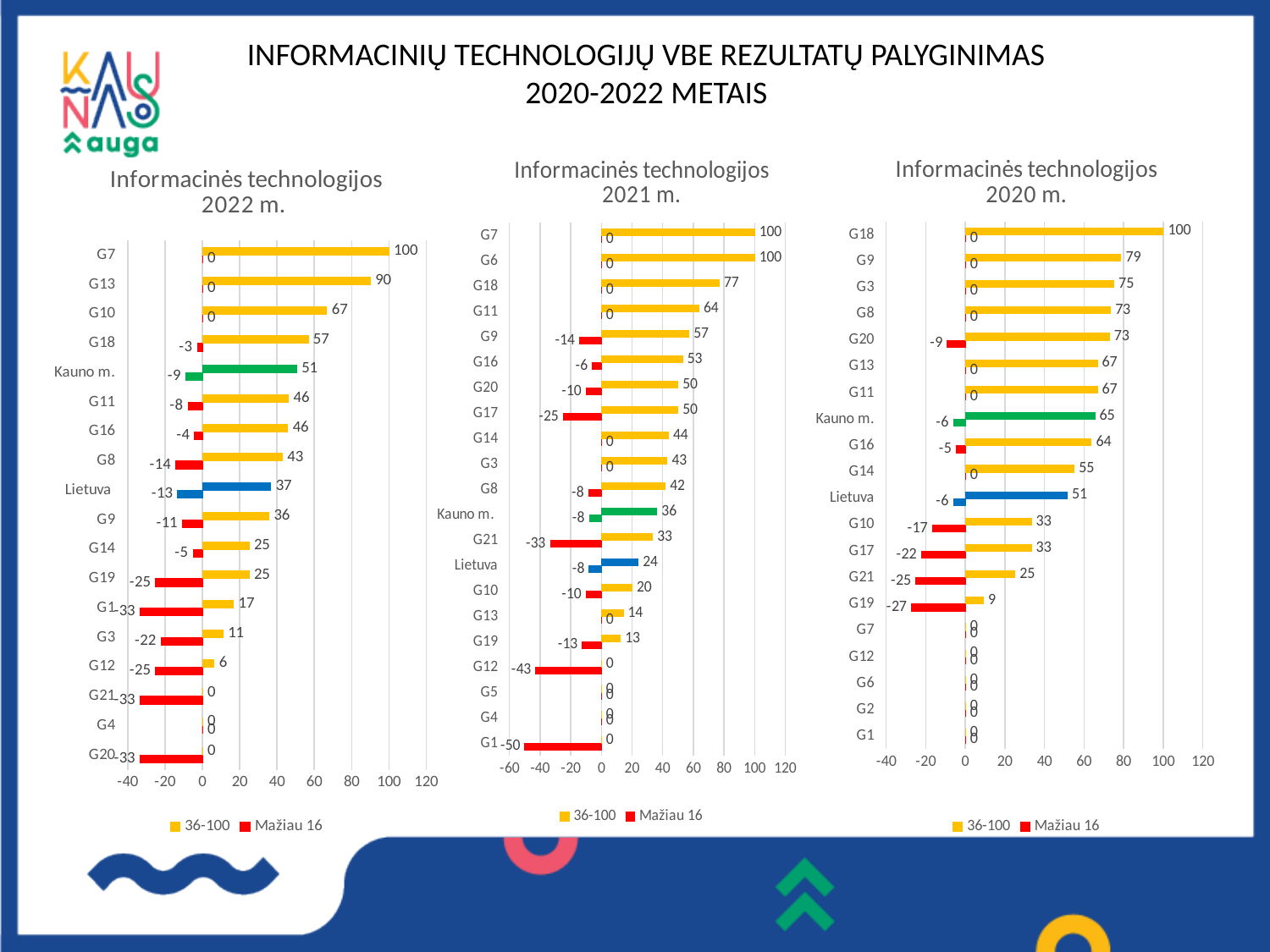
In the 'Informacinės technologijos 2022 m.' chart, what is the 'Mažiau 16' value for G8? -14 In the 'Informacinės technologijos 2020 m.' chart, which category has the highest '36-100' value? G18 How many series does the legend of the 'Informacinės technologijos 2022 m.' chart list? 2 What kind of chart is the 'Informacinės technologijos 2020 m.' chart? Bar chart In the 'Informacinės technologijos 2021 m.' chart, what is the 'Mažiau 16' value for G1? -50 In the 'Informacinės technologijos 2021 m.' chart, which is larger: the '36-100' value for G18 or for G11? G18 In the 'Informacinės technologijos 2020 m.' chart, what is the 'Mažiau 16' value for G19? -27 What are the two legend entries in the 'Informacinės technologijos 2021 m.' chart? 36-100 and Mažiau 16 In the 'Informacinės technologijos 2022 m.' chart, what is the '36-100' value for G13? 90 In the 'Informacinės technologijos 2022 m.' chart, what is the '36-100' value for Lietuva? 37 In the 'Informacinės technologijos 2021 m.' chart, what is the '36-100' value for Kauno m.? 36 In the 'Informacinės technologijos 2020 m.' chart, what is the difference between the '36-100' values for G9 and Lietuva? 28